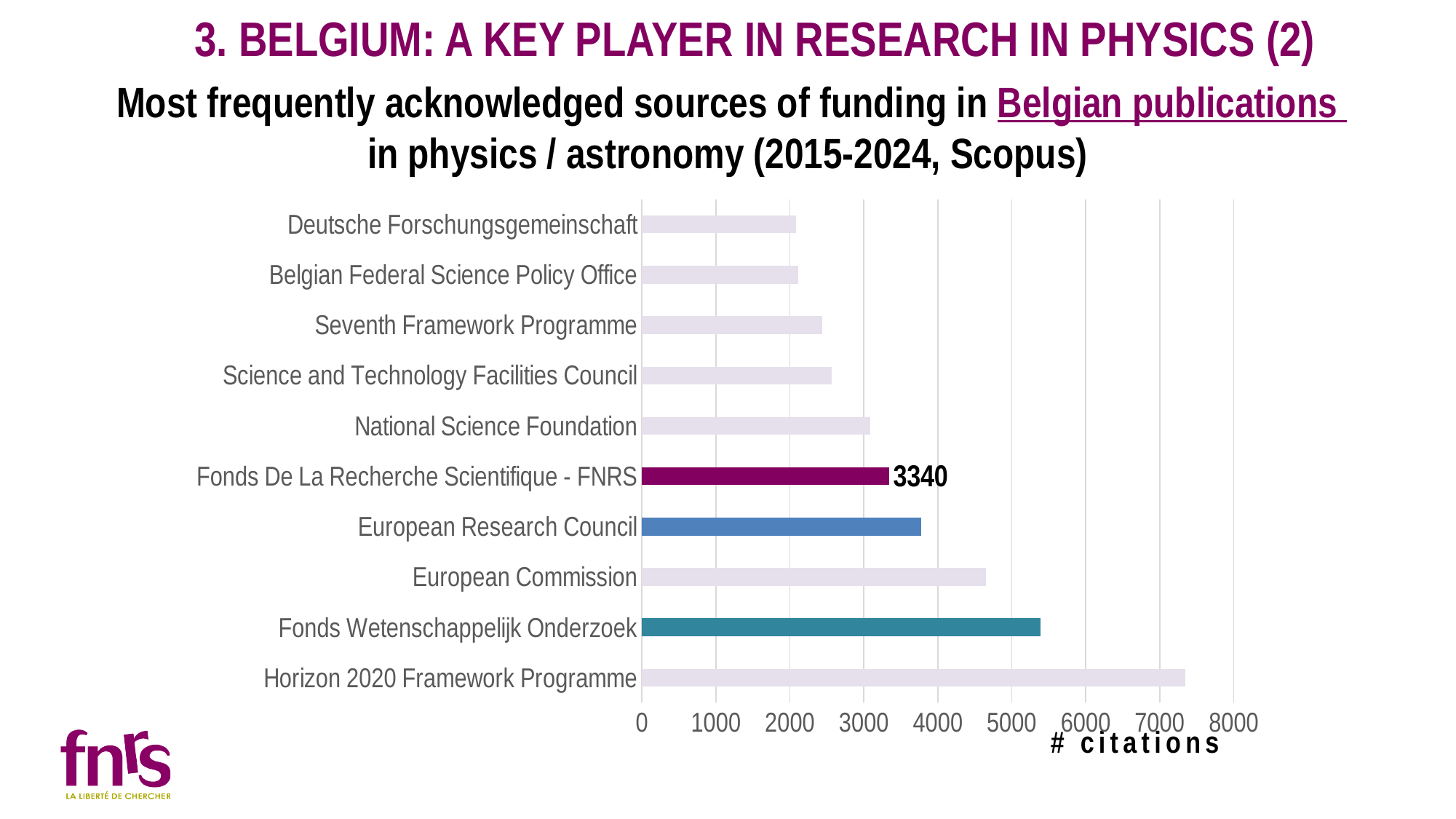
Is the value for Science and Technology Facilities Council greater or less than 3000? less How many citations are shown for Fonds De La Recherche Scientifique - FNRS? 3340 What is the label of the horizontal axis? # citations Which funding source has the highest number of citations? Horizon 2020 Framework Programme Is the value for Horizon 2020 Framework Programme greater or less than 7000? greater How many funding sources are listed in the chart? 10 Which has more citations, Fonds Wetenschappelijk Onderzoek or European Commission? Fonds Wetenschappelijk Onderzoek Is the value for European Research Council greater or less than 4000? less Which has more citations, European Research Council or Fonds De La Recherche Scientifique - FNRS? European Research Council What kind of chart is shown on the slide? Bar chart